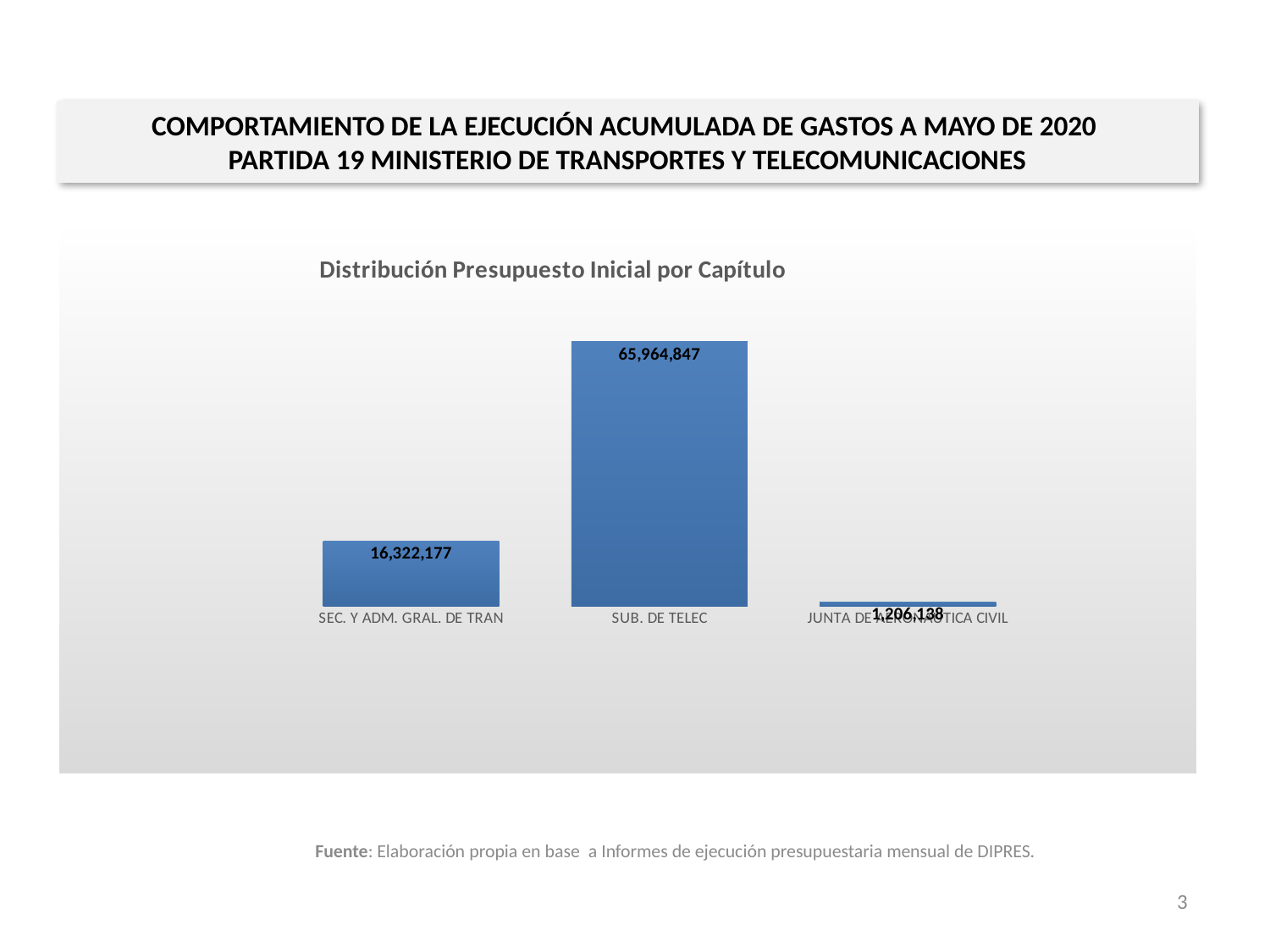
What is the difference between the values for SUB. DE TELEC and SEC. Y ADM. GRAL. DE TRAN? 49,642,670 Which is larger, the value for SEC. Y ADM. GRAL. DE TRAN or the value for JUNTA DE AERONAUTICA CIVIL? SEC. Y ADM. GRAL. DE TRAN What colour are the bars in the chart? Blue What is the value for SEC. Y ADM. GRAL. DE TRAN? 16,322,177 What is the title of the chart? Distribución Presupuesto Inicial por Capítulo What is the value for JUNTA DE AERONAUTICA CIVIL? 1,206,138 Which category has the lowest value? JUNTA DE AERONAUTICA CIVIL What is the difference between the values for SEC. Y ADM. GRAL. DE TRAN and JUNTA DE AERONAUTICA CIVIL? 15,116,039 How many categories are shown in the chart? 3 What kind of chart is shown on the slide? Bar chart What is the value for SUB. DE TELEC? 65,964,847 Which category has the highest value? SUB. DE TELEC